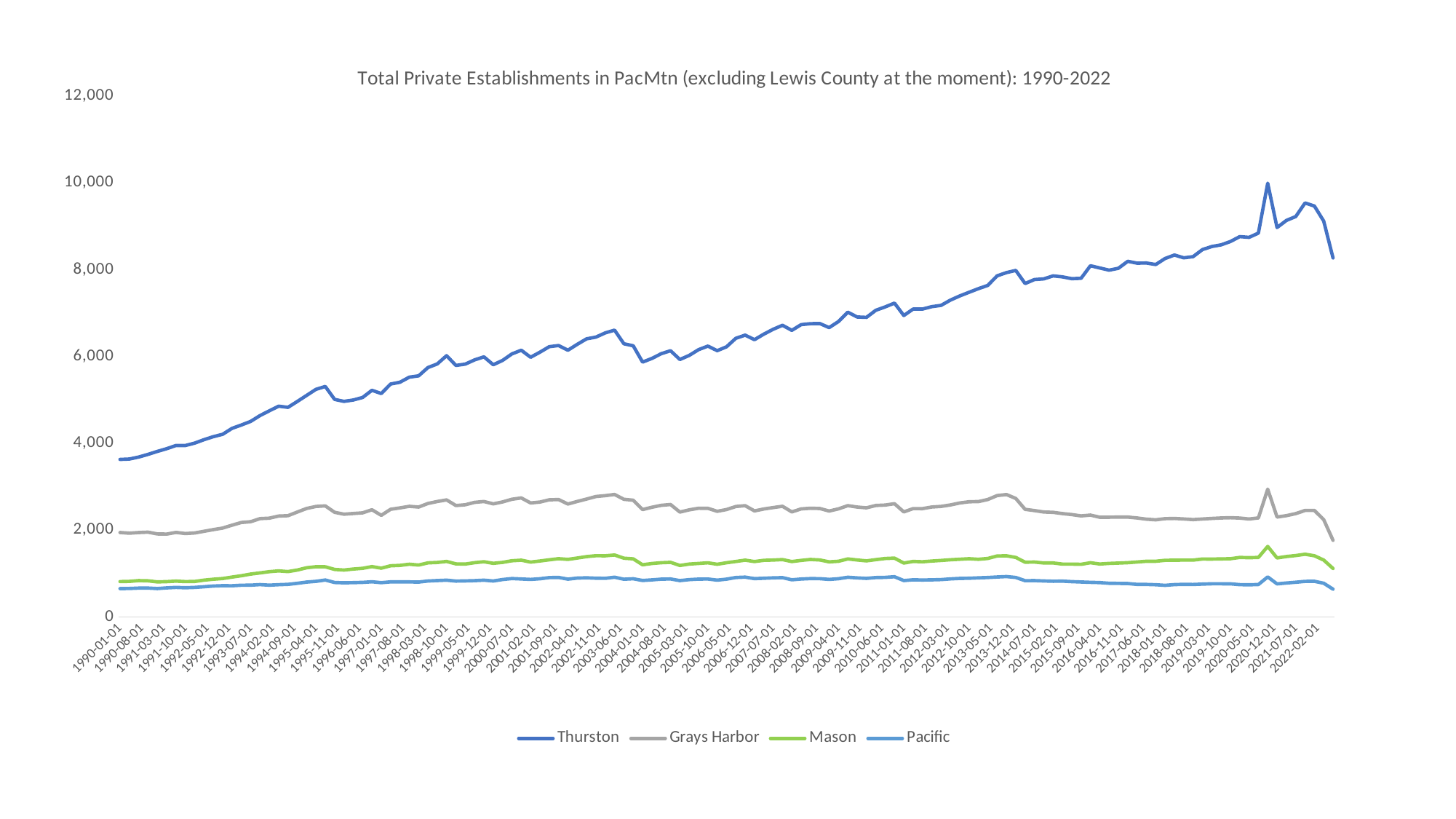
Is the value for Mason at 2013-05-01 greater or less than 2,000? less Is the value for Grays Harbor at 2003-06-01 greater or less than 2,000? greater At 2000-07-01, which is larger: the value for Thurston or the value for Grays Harbor? Thurston Which series has the lowest values throughout the chart? Pacific Which series has the highest values throughout the chart? Thurston How many series does the legend list? 4 Is the value for Thurston at 2010-06-01 greater or less than 6,000? greater At 2013-05-01, which is larger: the value for Mason or the value for Pacific? Mason Does the Thurston line generally rise or fall from 1990 to 2020? rise What kind of chart is shown on the slide? line chart What is the title of the chart? Total Private Establishments in PacMtn (excluding Lewis County at the moment): 1990-2022